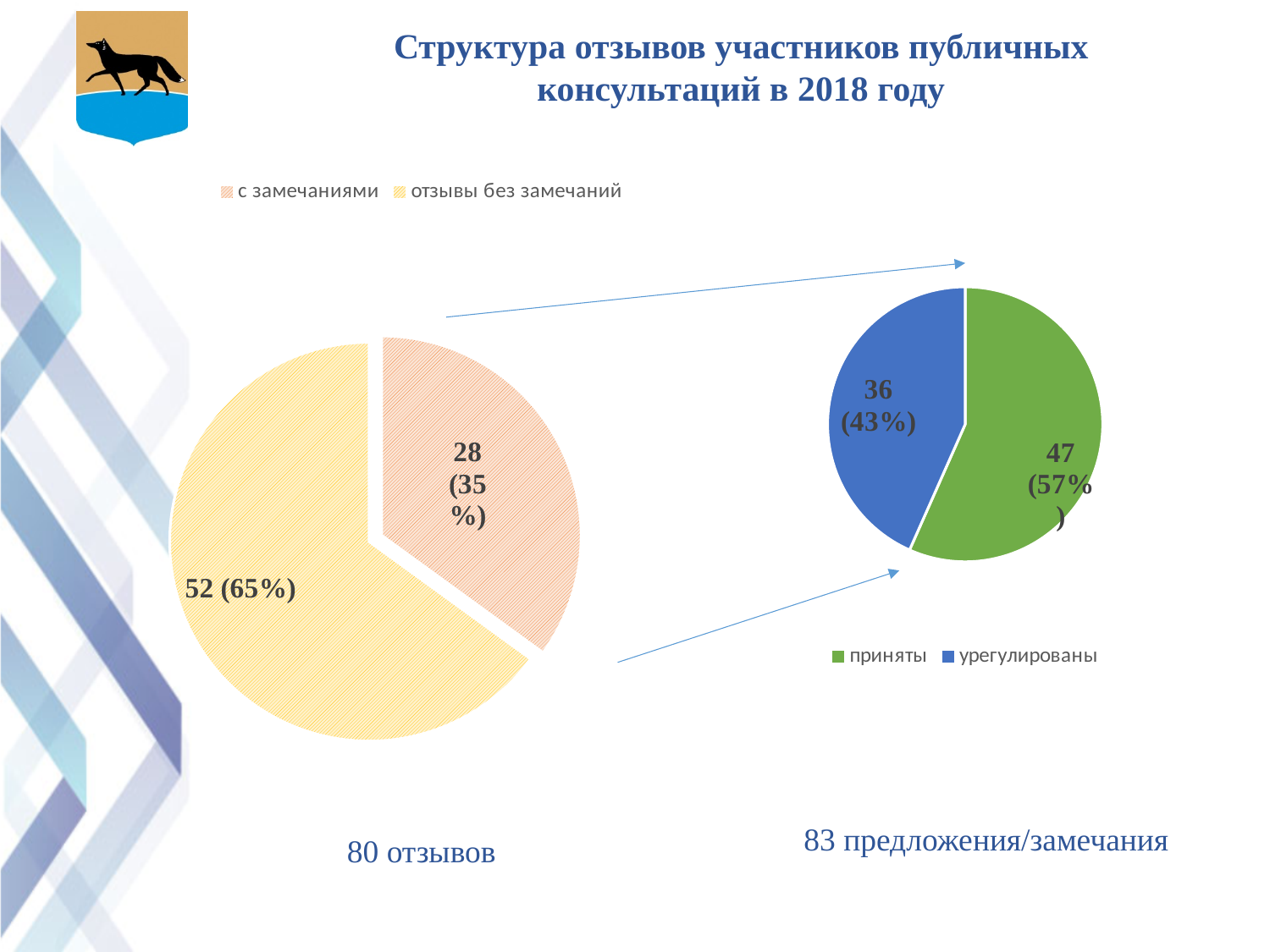
In the left pie chart (80 отзывов), what share of the pie does 'с замечаниями' take? 35% How many series does the legend of the left pie chart (80 отзывов) list? 2 In the left pie chart (80 отзывов), what is the value for 'с замечаниями'? 28 (35%) In the left pie chart (80 отзывов), which category has the largest slice? отзывы без замечаний In the right pie chart (83 предложения/замечания), which is larger: 'приняты' or 'урегулированы'? приняты In the right pie chart (83 предложения/замечания), what is the value for 'урегулированы'? 36 (43%) In the right pie chart (83 предложения/замечания), what is the difference between the counts for 'приняты' and 'урегулированы'? 11 In the left pie chart (80 отзывов), what is the difference between the counts for 'отзывы без замечаний' and 'с замечаниями'? 24 What kind of chart is the right chart (83 предложения/замечания)? pie chart In the right pie chart (83 предложения/замечания), what is the value for 'приняты'? 47 (57%) In the left pie chart (80 отзывов), what is the value for 'отзывы без замечаний'? 52 (65%) In the right pie chart (83 предложения/замечания), which category has the smallest slice? урегулированы